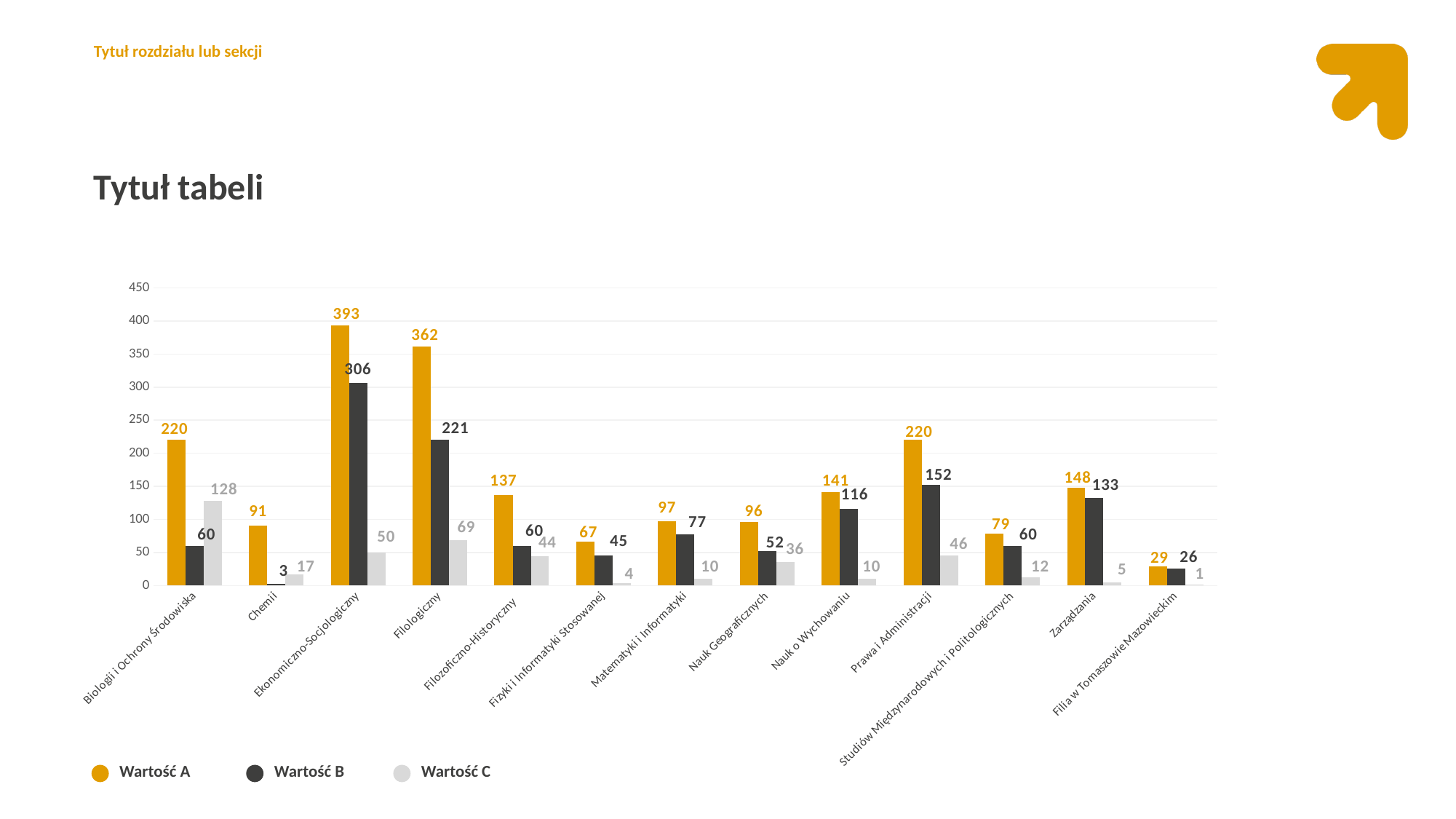
What is the Wartość C value for Biologii i Ochrony Środowiska? 128 How many series does the legend list? 3 What kind of chart is shown on the slide? Bar chart What is the difference between Wartość A and Wartość B for Prawa i Administracji? 68 What is the Wartość A value for Ekonomiczno-Socjologiczny? 393 How many categories are shown on the x axis? 13 Which category has the lowest Wartość C value? Filia w Tomaszowie Mazowieckim What is the title of the chart? Tytuł tabeli What is the Wartość B value for Chemii? 3 Which is larger: Wartość B for Nauk o Wychowaniu or Wartość B for Zarządzania? Wartość B for Zarządzania What is the Wartość B value for Filologiczny? 221 Which category has the highest Wartość A value? Ekonomiczno-Socjologiczny